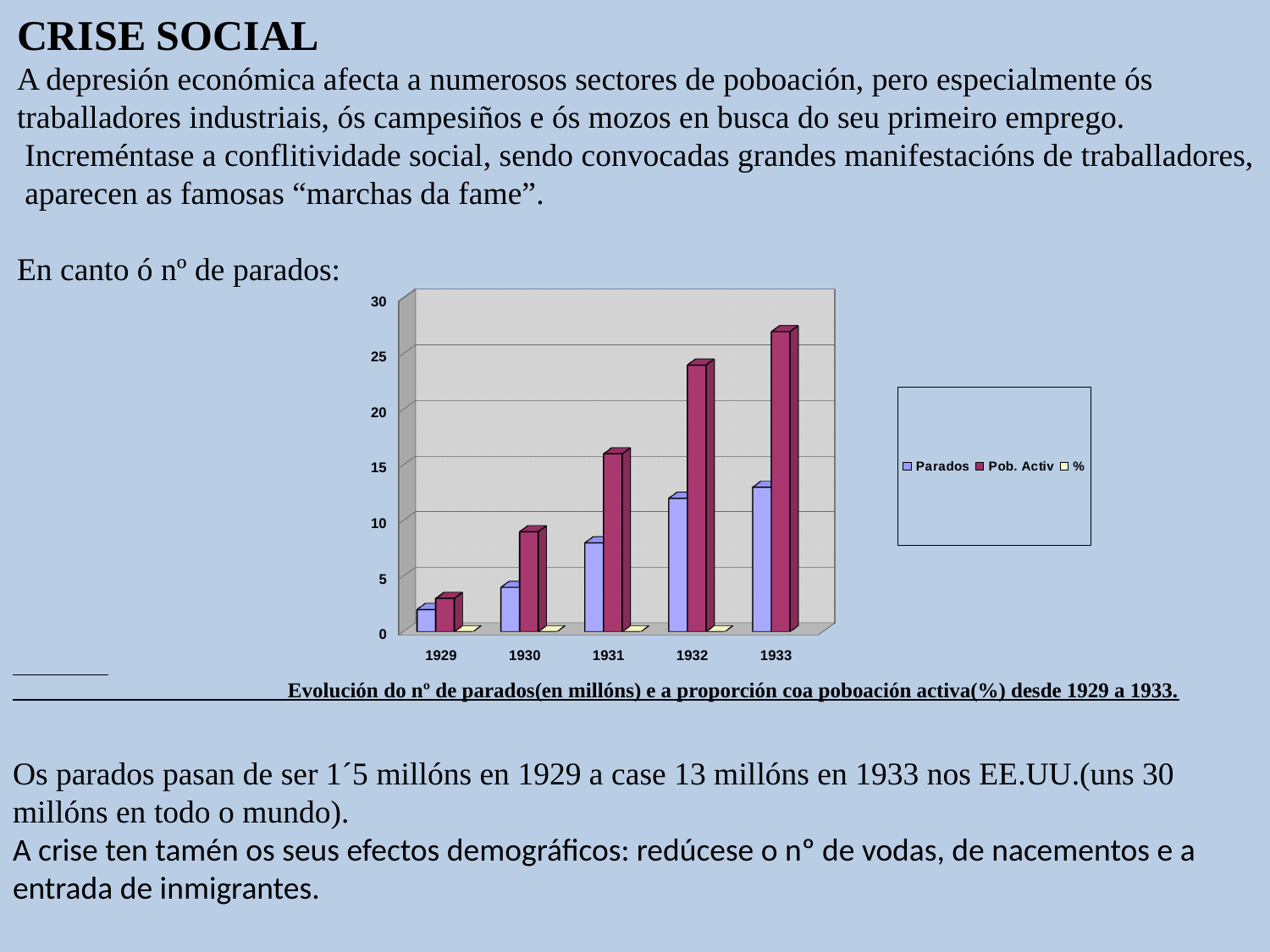
In 1932, which is larger: Parados or Pob. Activ? Pob. Activ Which year has the lowest value for Parados? 1929 Is the value for Parados in 1933 greater or less than 10? greater Which year has the highest value for Pob. Activ? 1933 Is the value for Parados in 1931 greater or less than 10? less What are the three series named in the chart legend? Parados, Pob. Activ, % How many years are shown on the x axis of the chart? 5 Is the value for Pob. Activ in 1933 greater or less than 25? greater How many series does the chart legend list? 3 Do the Parados values rise or fall from 1929 to 1933? rise What kind of chart is shown on the slide? bar chart